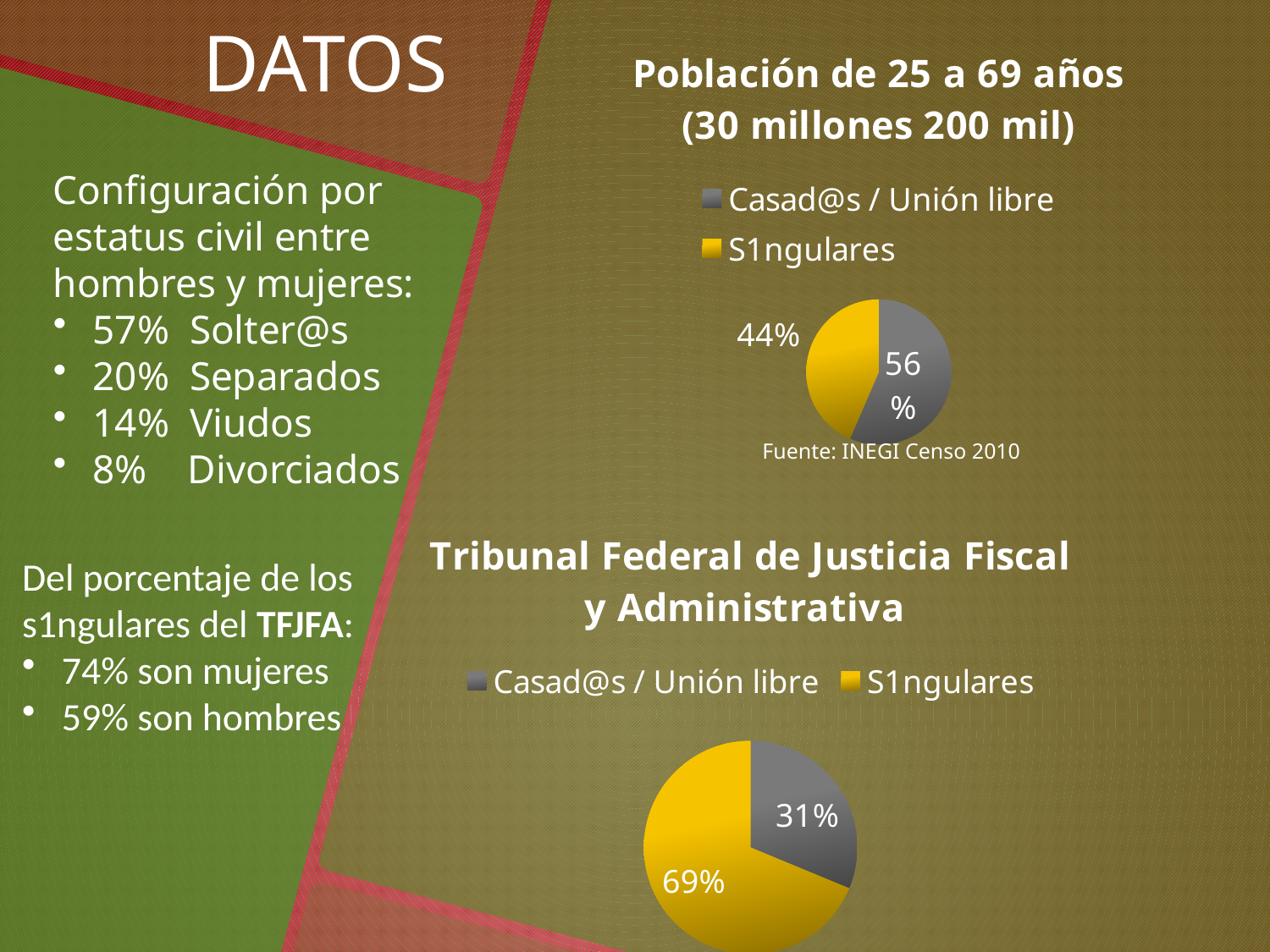
What source is cited below the 'Población de 25 a 69 años' chart? Fuente: INEGI Censo 2010 In the 'Tribunal Federal de Justicia Fiscal y Administrativa' chart, what share is S1ngulares? 69% In the 'Tribunal Federal de Justicia Fiscal y Administrativa' chart, which category has the smaller slice? Casad@s / Unión libre What type of chart is the 'Tribunal Federal de Justicia Fiscal y Administrativa' chart? Pie chart In the 'Población de 25 a 69 años' chart, what share is Casad@s / Unión libre? 56% In the 'Tribunal Federal de Justicia Fiscal y Administrativa' chart, what share is Casad@s / Unión libre? 31% In the 'Población de 25 a 69 años' chart, what share is S1ngulares? 44% In the 'Población de 25 a 69 años' chart, which category has the larger slice? Casad@s / Unión libre How many categories does the legend of the 'Población de 25 a 69 años' chart list? 2 In the 'Población de 25 a 69 años' chart, what is the difference between the Casad@s / Unión libre and S1ngulares shares? 12 percentage points In the 'Tribunal Federal de Justicia Fiscal y Administrativa' chart, what is the difference between the S1ngulares and Casad@s / Unión libre shares? 38 percentage points Is the S1ngulares share larger in the 'Población de 25 a 69 años' chart or in the 'Tribunal Federal de Justicia Fiscal y Administrativa' chart? Tribunal Federal de Justicia Fiscal y Administrativa